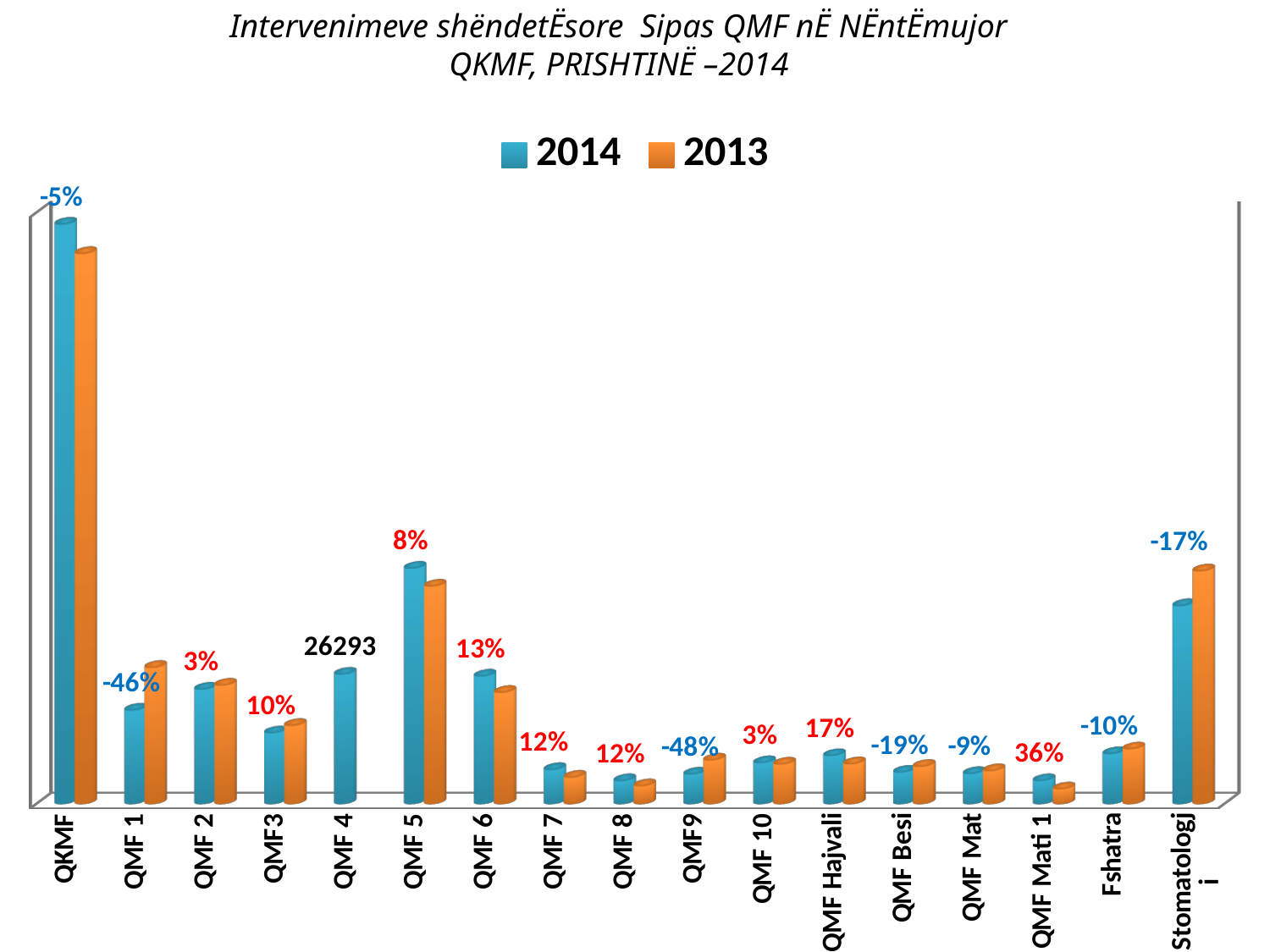
For QKMF, which bar is taller, 2014 or 2013? 2014 What value is printed above the QMF 4 bar? 26293 What percentage label is printed above the QMF 1 bars? -46% Which category has the tallest bars? QKMF Which category shows only a 2014 bar and no 2013 bar? QMF 4 What kind of chart is shown on the slide? bar chart What percentage label is printed above the QMF 5 bars? 8% How many categories are shown along the x axis? 17 How many series does the legend list? 2 What are the two series named in the legend? 2014 and 2013 For Stomatologji, which bar is taller, 2014 or 2013? 2013 What percentage label is printed above the Stomatologji bars? -17%